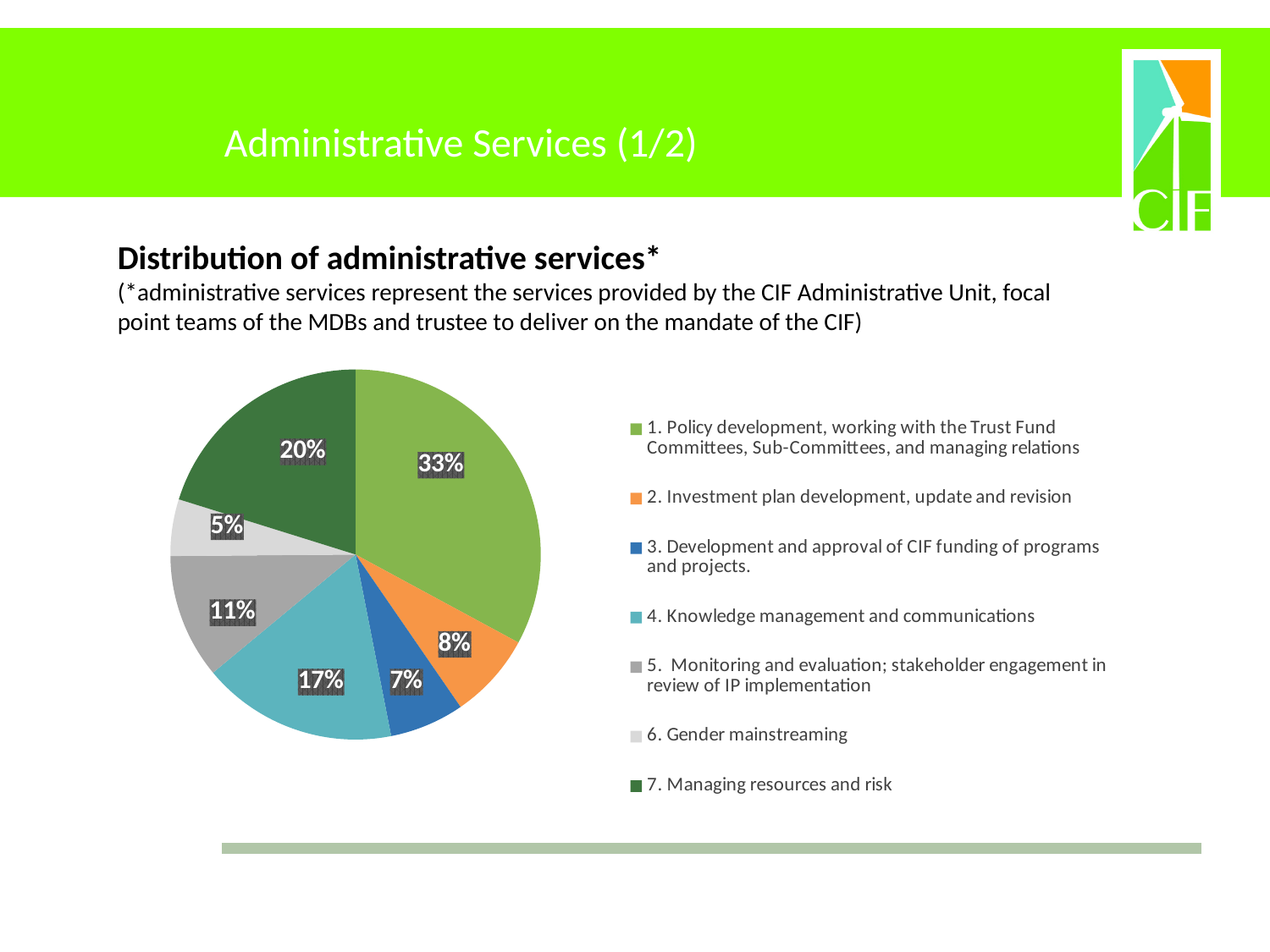
Which category has the largest share of the pie? 1. Policy development, working with the Trust Fund Committees, Sub-Committees, and managing relations What kind of chart is shown on the slide? Pie chart Which category has the smallest share of the pie? 6. Gender mainstreaming What share of administrative services is for 1. Policy development, working with the Trust Fund Committees, Sub-Committees, and managing relations? 33% What is the title of the chart on the slide? Distribution of administrative services* What share of administrative services is for 2. Investment plan development, update and revision? 8% How many categories does the pie chart show? 7 Which has a larger share: 3. Development and approval of CIF funding of programs and projects, or 2. Investment plan development, update and revision? 2. Investment plan development, update and revision What share of administrative services is for 7. Managing resources and risk? 20% What is the difference in percentage points between the share for 7. Managing resources and risk and the share for 5. Monitoring and evaluation; stakeholder engagement in review of IP implementation? 9